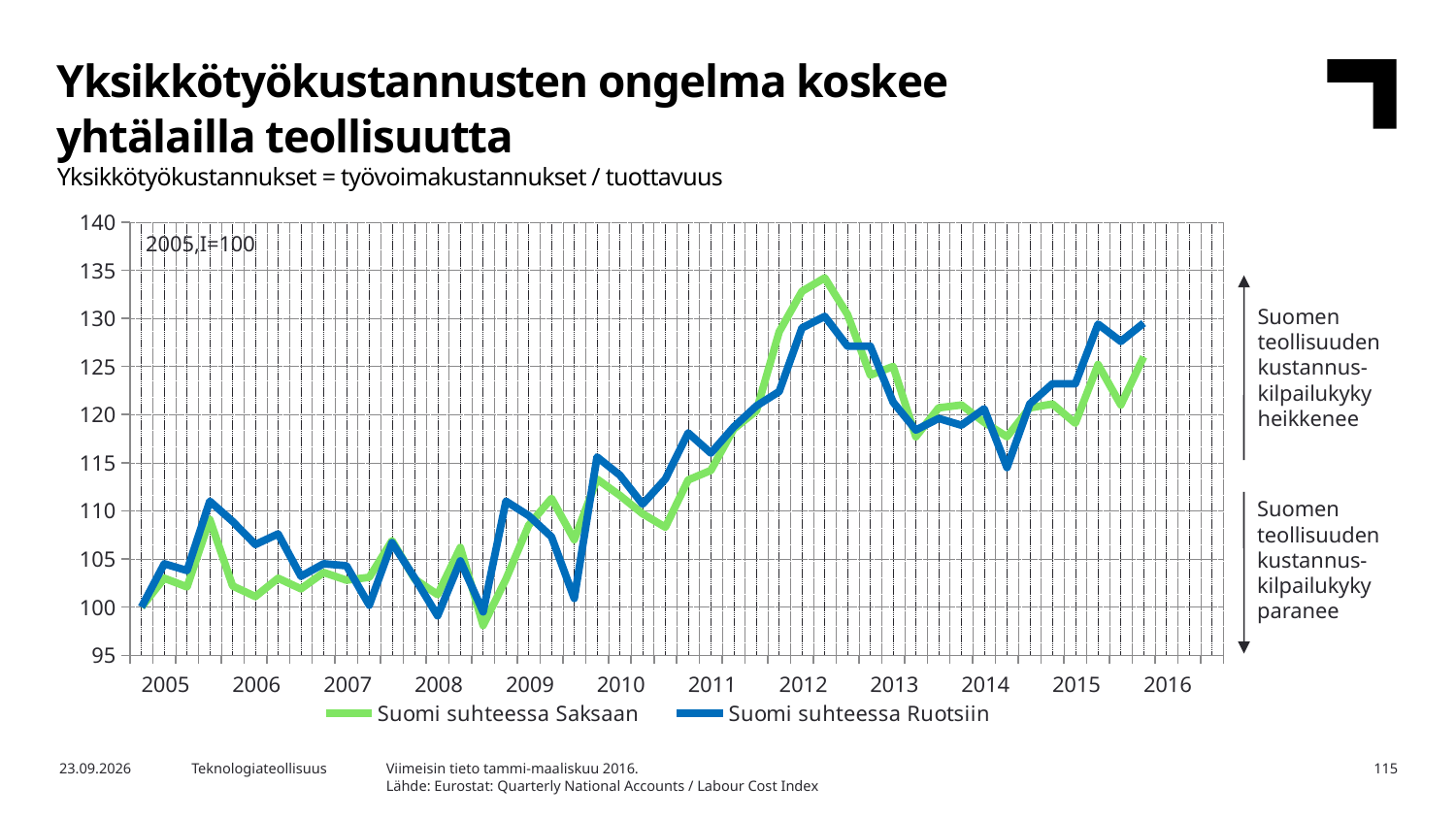
What base period and value does the chart annotation give for the index? 2005,I=100 What kind of chart is shown on the slide? line chart Which series reaches the higher peak in 2012, Suomi suhteessa Saksaan or Suomi suhteessa Ruotsiin? Suomi suhteessa Saksaan Is the value of the Suomi suhteessa Ruotsiin series at the end of 2015 greater or less than 125? greater Do the values of the Suomi suhteessa Ruotsiin series rise or fall between 2009 and 2012? rise Is the lowest value of the Suomi suhteessa Saksaan series in 2008 greater or less than 100? less In which year does the Suomi suhteessa Saksaan series reach its highest value? 2012 Which two series are listed in the legend? Suomi suhteessa Saksaan; Suomi suhteessa Ruotsiin How many series does the legend list? 2 What is the range of the vertical axis? 95 to 140 Is the peak value of the Suomi suhteessa Saksaan series in 2012 greater or less than 130? greater What is the index value of both series at the start of 2005? 100